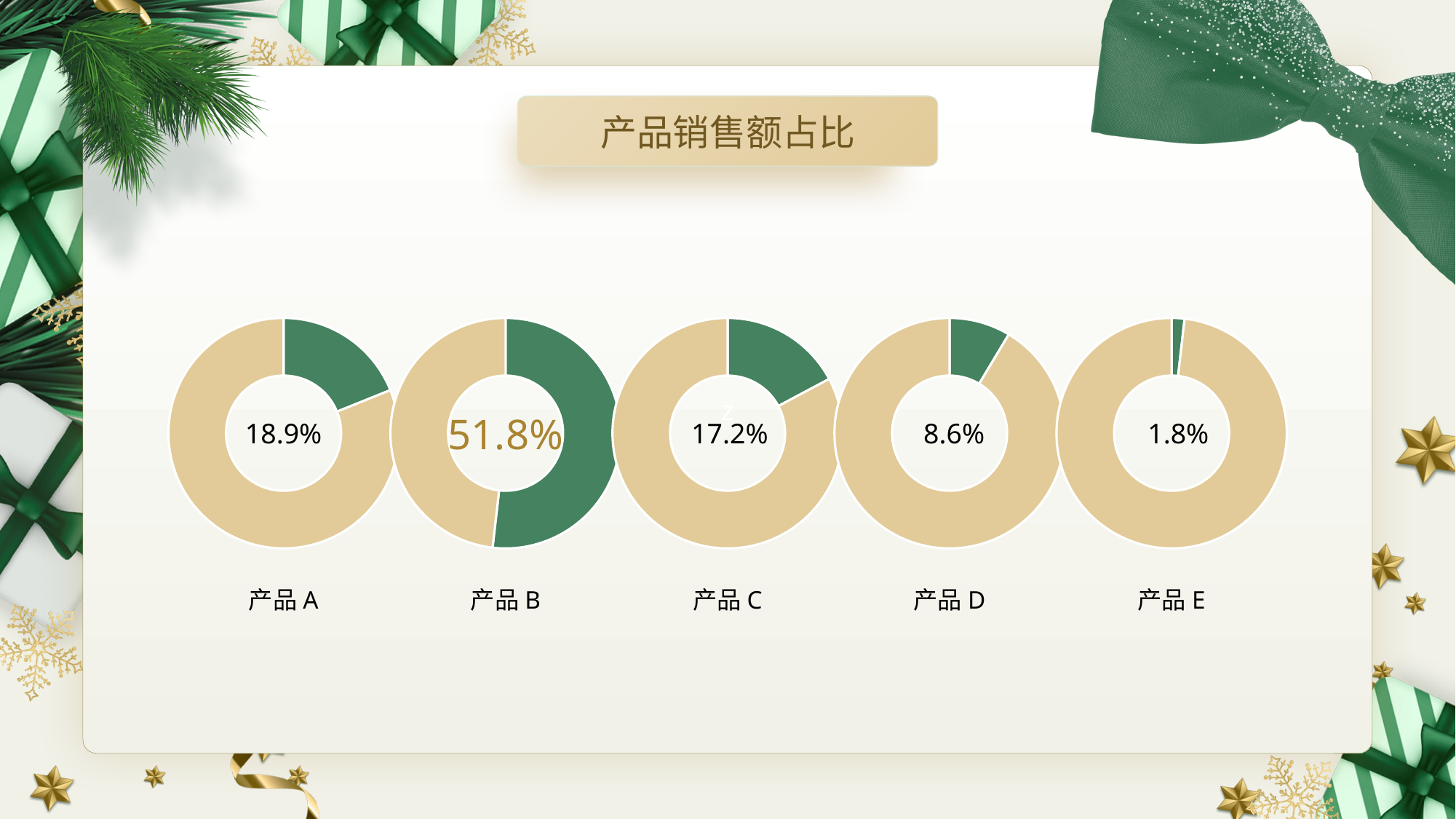
What percentage is shown in the centre of the 产品 B donut chart? 51.8% Which has the larger share, 产品 A or 产品 C? 产品 A What percentage is shown in the centre of the 产品 C donut chart? 17.2% What kind of chart is used for each product on the slide? Donut (pie) chart What is the title shown above the charts on the slide? 产品销售额占比 What percentage is shown in the centre of the 产品 E donut chart? 1.8% How many donut charts are shown on the slide? 5 Across the five donut charts, which product has the lowest sales share? 产品 E What is the difference between the percentage shown for 产品 B and the percentage shown for 产品 A? 32.9% Across the five donut charts, which product has the highest sales share? 产品 B What percentage is shown in the centre of the 产品 A donut chart? 18.9% What percentage is shown in the centre of the 产品 D donut chart? 8.6%